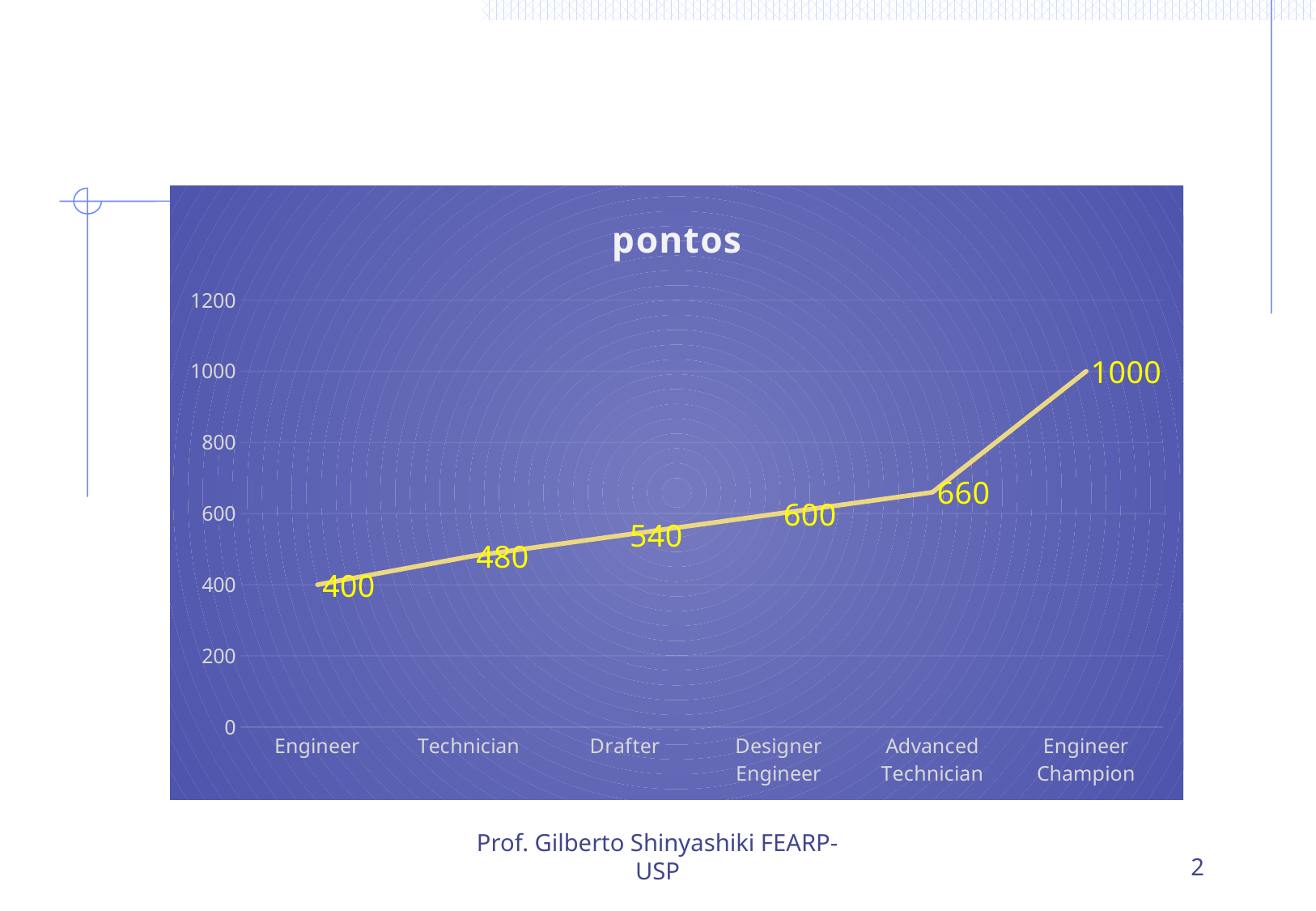
How many categories are shown on the x axis? 6 Which category has the highest value? Engineer Champion What is the value for Engineer? 400 Do the values rise or fall from Engineer to Engineer Champion? rise What is the difference between the values for Engineer Champion and Advanced Technician? 340 Is the value for Designer Engineer greater or less than 800? less Which is larger, the value for Technician or the value for Drafter? Drafter What kind of chart is shown? line chart What is the difference between the values for Designer Engineer and Technician? 120 What is the value for Drafter? 540 Which category has the lowest value? Engineer What is the value for Advanced Technician? 660